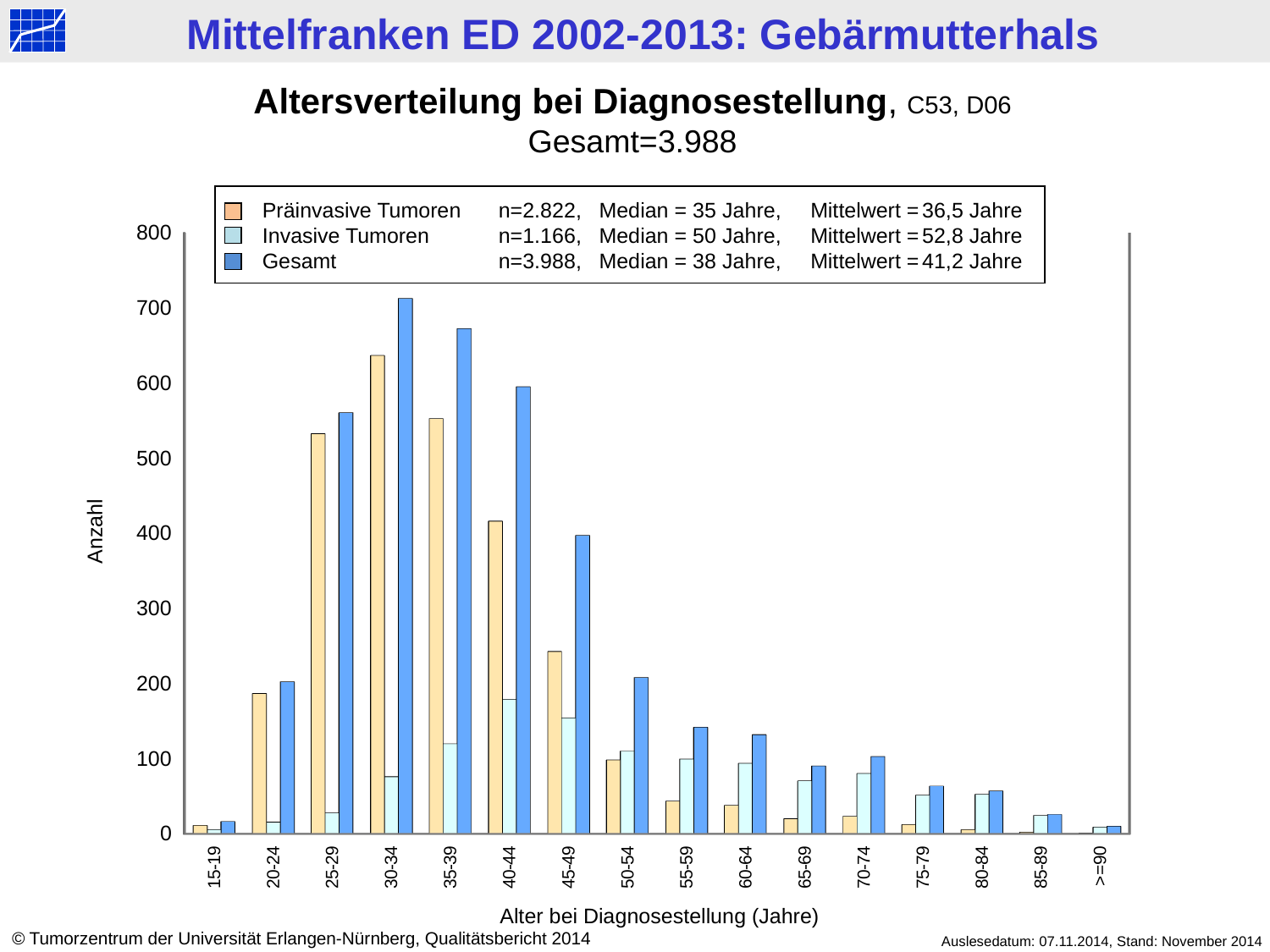
Is the Gesamt value for the 30-34 age group greater or less than 700? greater Which age group has the highest value for the Gesamt series? 30-34 How many age groups are shown on the x axis? 16 Which age group has the highest value for the Invasive Tumoren series? 40-44 Do the Gesamt values rise or fall from the 35-39 age group to the >=90 age group? fall According to the legend, what is the median age for Invasive Tumoren? 50 Jahre In the 60-64 age group, which is larger: Präinvasive Tumoren or Invasive Tumoren? Invasive Tumoren Is the Präinvasive Tumoren value for the 45-49 age group greater or less than 300? less What kind of chart is shown on the slide? bar chart Which age group has the highest value for the Präinvasive Tumoren series? 30-34 How many series does the legend list? 3